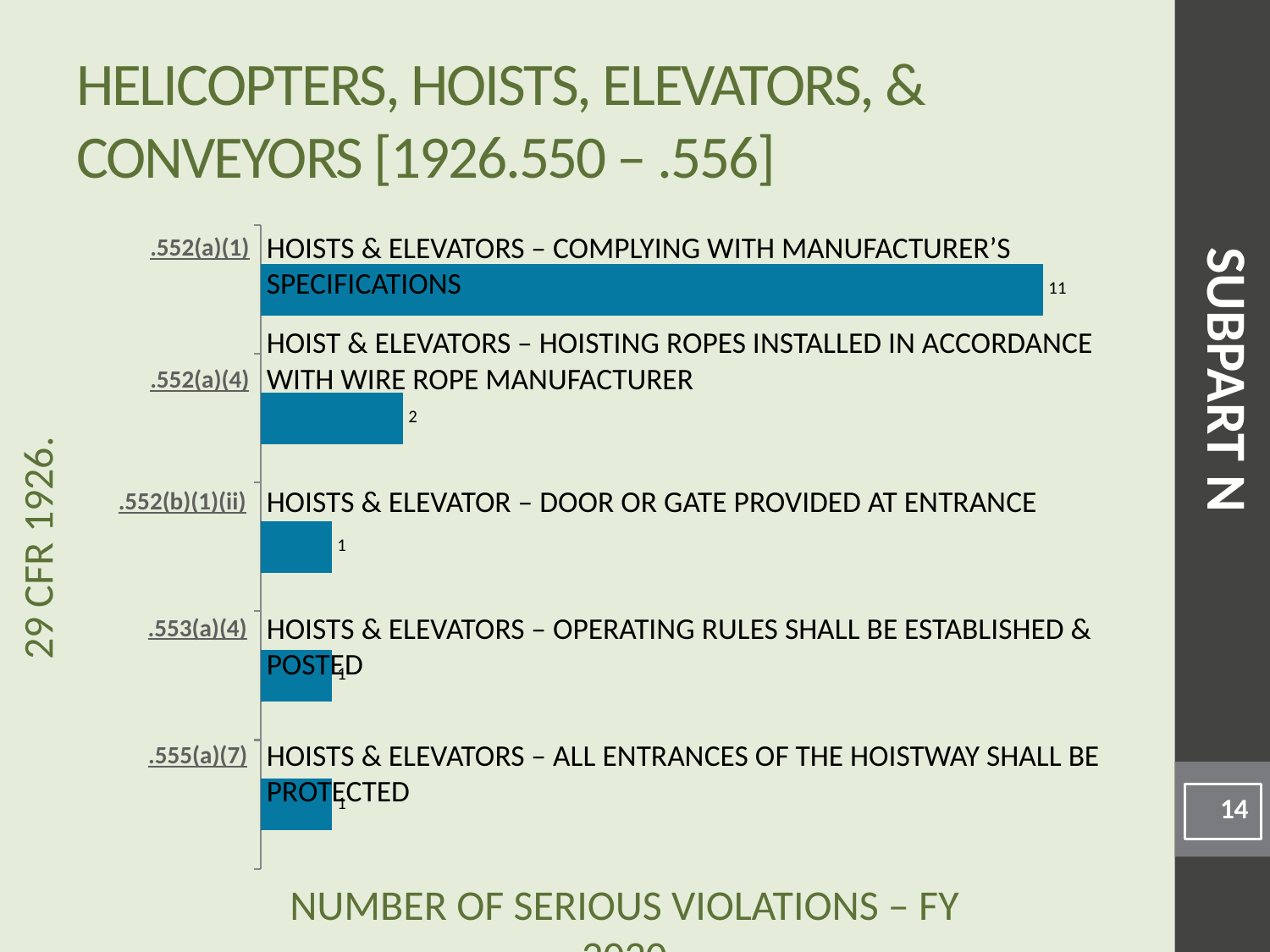
What is the number of serious violations for .552(a)(4)? 2 What colour are the bars in the chart? Blue How many standards (categories) are shown in the chart? 5 What is the difference between the number of serious violations for .552(a)(1) and .552(a)(4)? 9 Which standard has the highest number of serious violations? .552(a)(1) What is the total number of serious violations across all five standards shown? 16 Which has more serious violations, .552(a)(4) or .552(b)(1)(ii)? .552(a)(4) What is the description given for standard .552(b)(1)(ii) in the chart? HOISTS & ELEVATOR – DOOR OR GATE PROVIDED AT ENTRANCE What is the number of serious violations for .552(b)(1)(ii)? 1 What is the number of serious violations for .552(a)(1)? 11 What kind of chart is shown on the slide? Bar chart What is the difference between the number of serious violations for .552(a)(4) and .553(a)(4)? 1